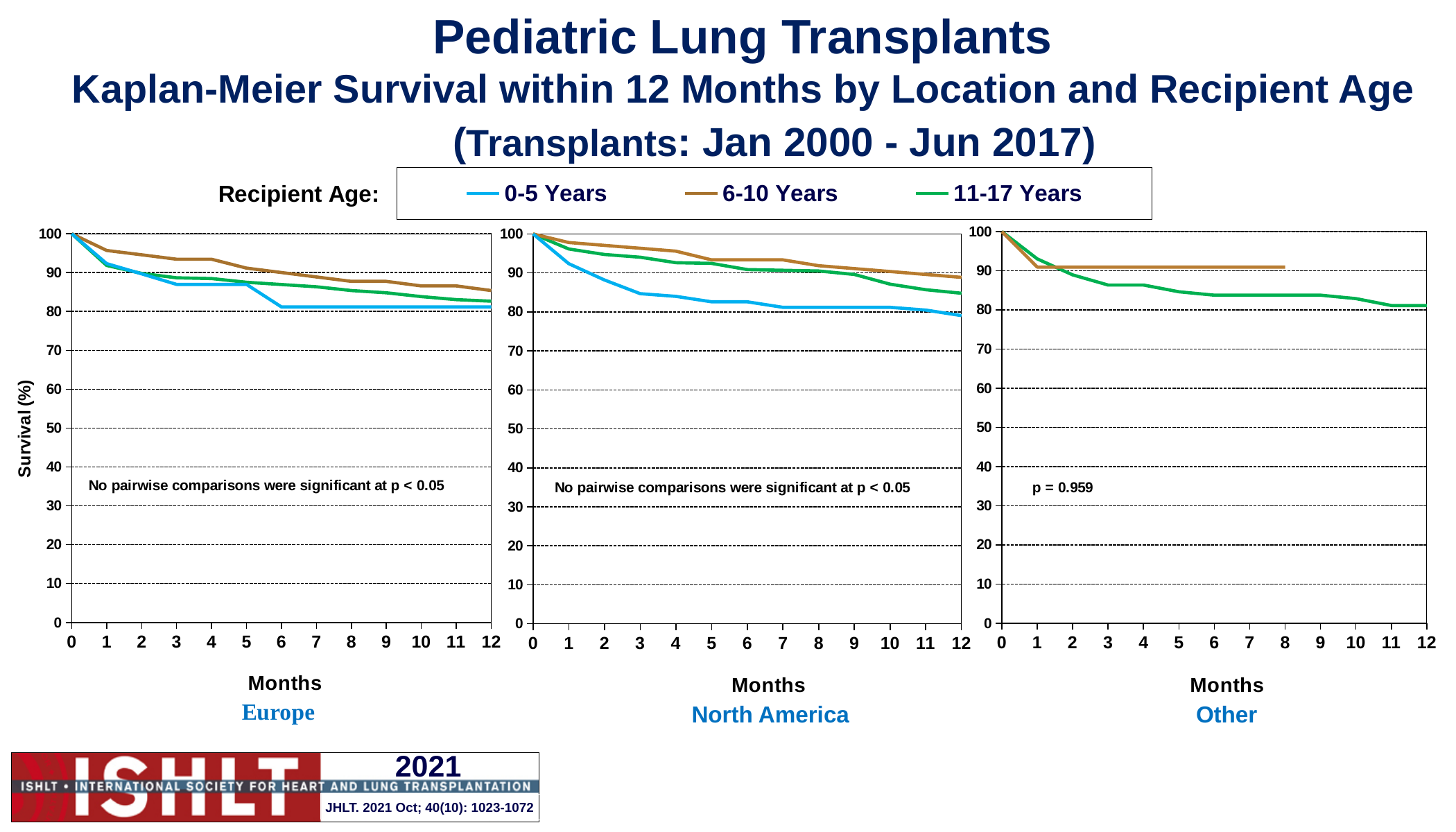
In the North America chart, is the survival value for 6-10 Years at month 12 greater or less than 80? greater In the Europe chart, what is the survival value for all age groups at month 0? 100 In the Europe chart, is the survival value for 6-10 Years at month 12 greater or less than 80? greater What p-value is printed on the Other chart? p = 0.959 In the North America chart, which age group has the lowest survival at month 12? 0-5 Years In the Europe chart, is the survival value for 0-5 Years at month 12 greater or less than 90? less In the Europe chart, does the survival curve for 0-5 Years rise or fall over the 12 months? fall In the Europe chart, which age group has the higher survival at month 12: 0-5 Years or 6-10 Years? 6-10 Years What kind of chart is used for the Europe panel? line chart How many recipient age groups does the legend list? 3